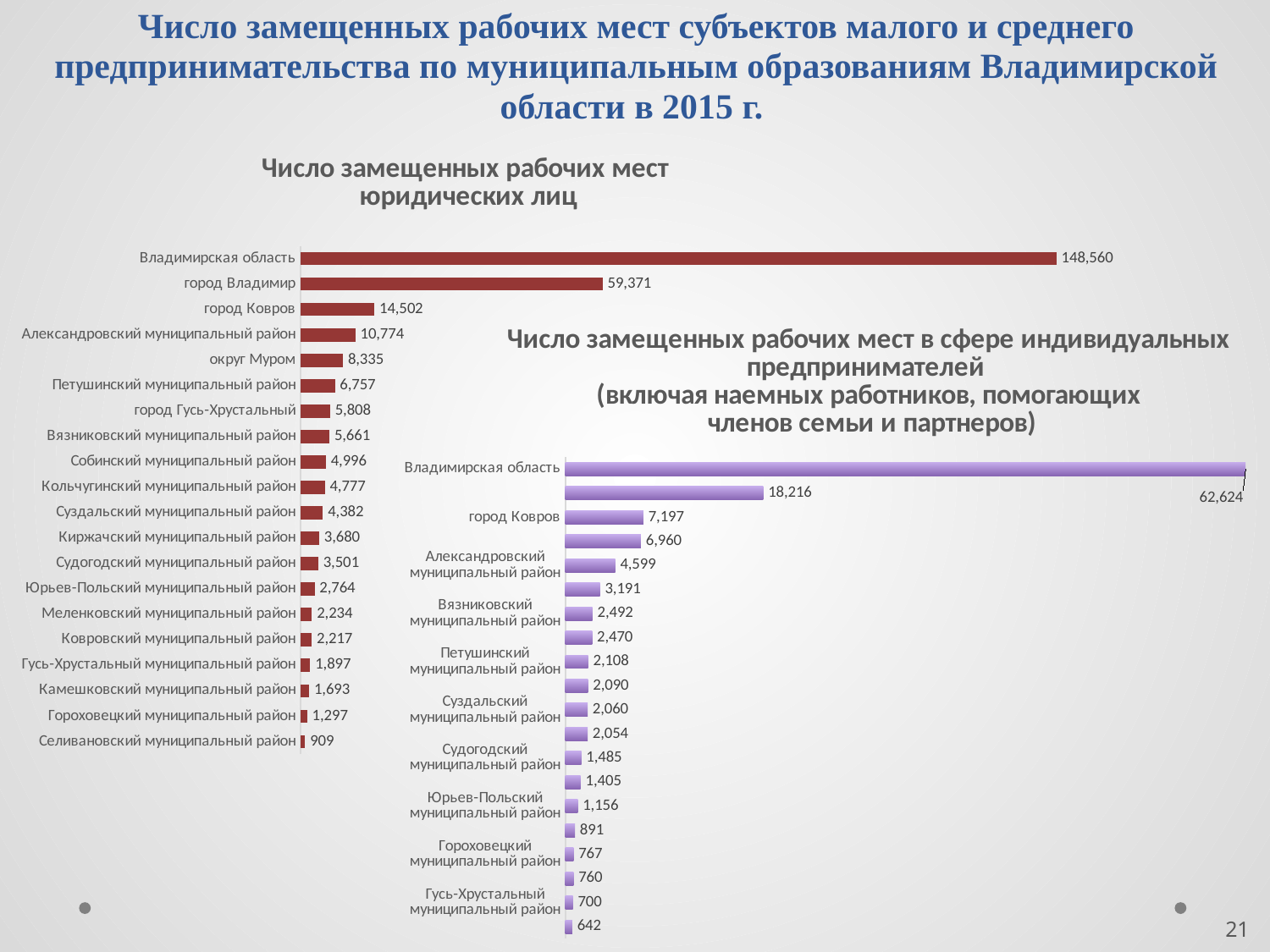
In the chart 'Число замещенных рабочих мест юридических лиц', what is the difference between город Ковров and Александровский муниципальный район? 3,728 In the chart 'Число замещенных рабочих мест в сфере индивидуальных предпринимателей', which category has the highest value? Владимирская область In the chart 'Число замещенных рабочих мест юридических лиц', which category has the highest value? Владимирская область In the chart 'Число замещенных рабочих мест юридических лиц', which is larger: Собинский муниципальный район or Кольчугинский муниципальный район? Собинский муниципальный район How many categories are shown in the chart 'Число замещенных рабочих мест юридических лиц'? 20 In the chart 'Число замещенных рабочих мест юридических лиц', what is the value for Селивановский муниципальный район? 909 In the chart 'Число замещенных рабочих мест в сфере индивидуальных предпринимателей', what is the value for город Ковров? 7,197 In the chart 'Число замещенных рабочих мест в сфере индивидуальных предпринимателей', what is the value for Владимирская область? 62,624 In the chart 'Число замещенных рабочих мест юридических лиц', what is the value for город Владимир? 59,371 What colour are the bars in the left chart 'Число замещенных рабочих мест юридических лиц'? Dark red In the chart 'Число замещенных рабочих мест юридических лиц', which category has the lowest value? Селивановский муниципальный район What kind of chart is the left chart 'Число замещенных рабочих мест юридических лиц'? Bar chart